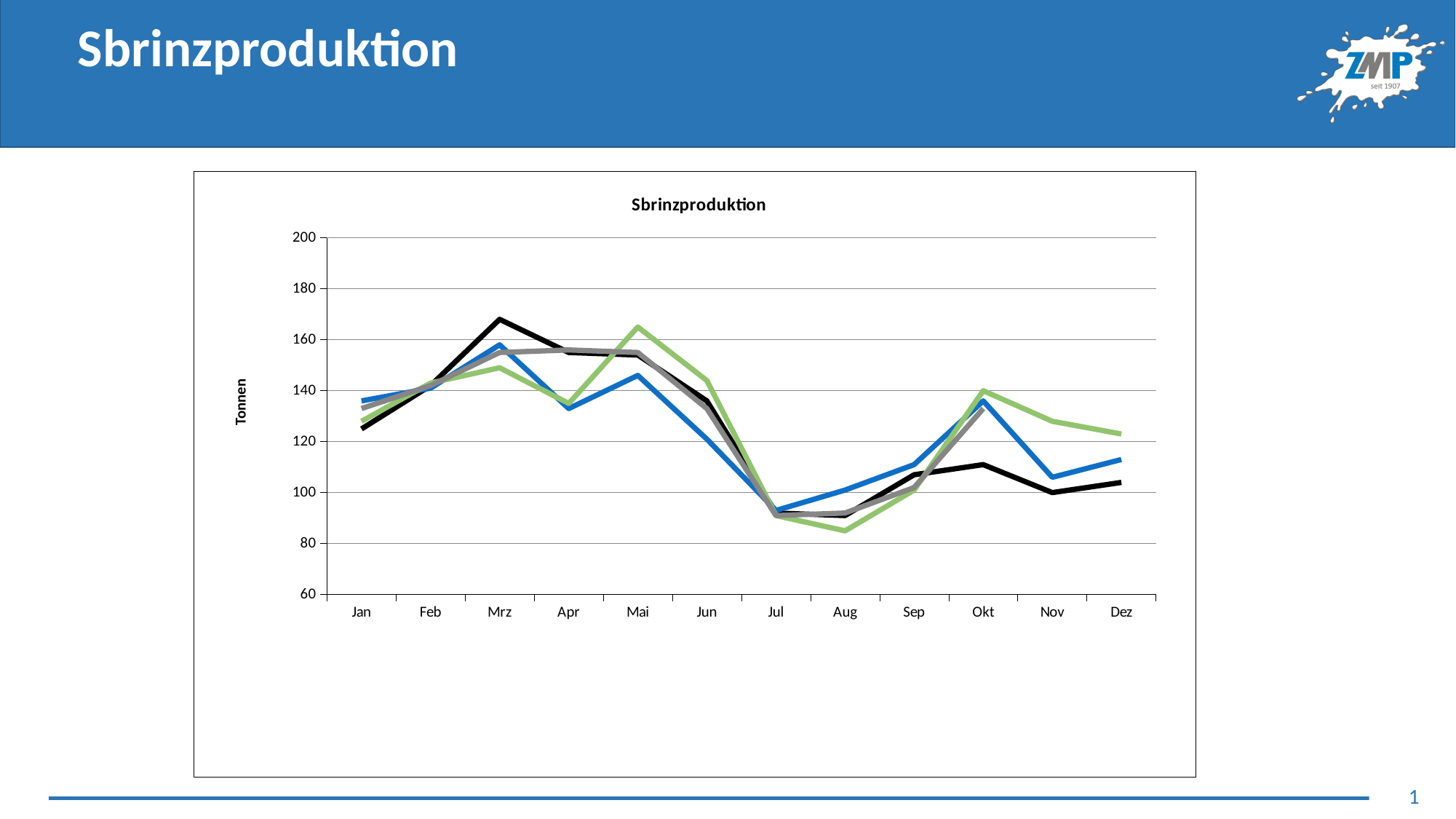
In which month does the green line reach its lowest value? Aug In Dez, which line has the higher value, the green line or the black line? green line In which month does the black line reach its highest value? Mrz Is the value of the green line in Aug greater or less than 100? less What is the label of the vertical axis? Tonnen What is the title of the chart? Sbrinzproduktion How many months are shown on the x axis of the chart? 12 What kind of chart is shown on the slide? line chart Is the value of the black line in Mrz greater or less than 160? greater In which month does the green line reach its highest value? Mai How many lines are plotted in the chart? 4 Do the lines rise or fall from Jun to Jul? fall